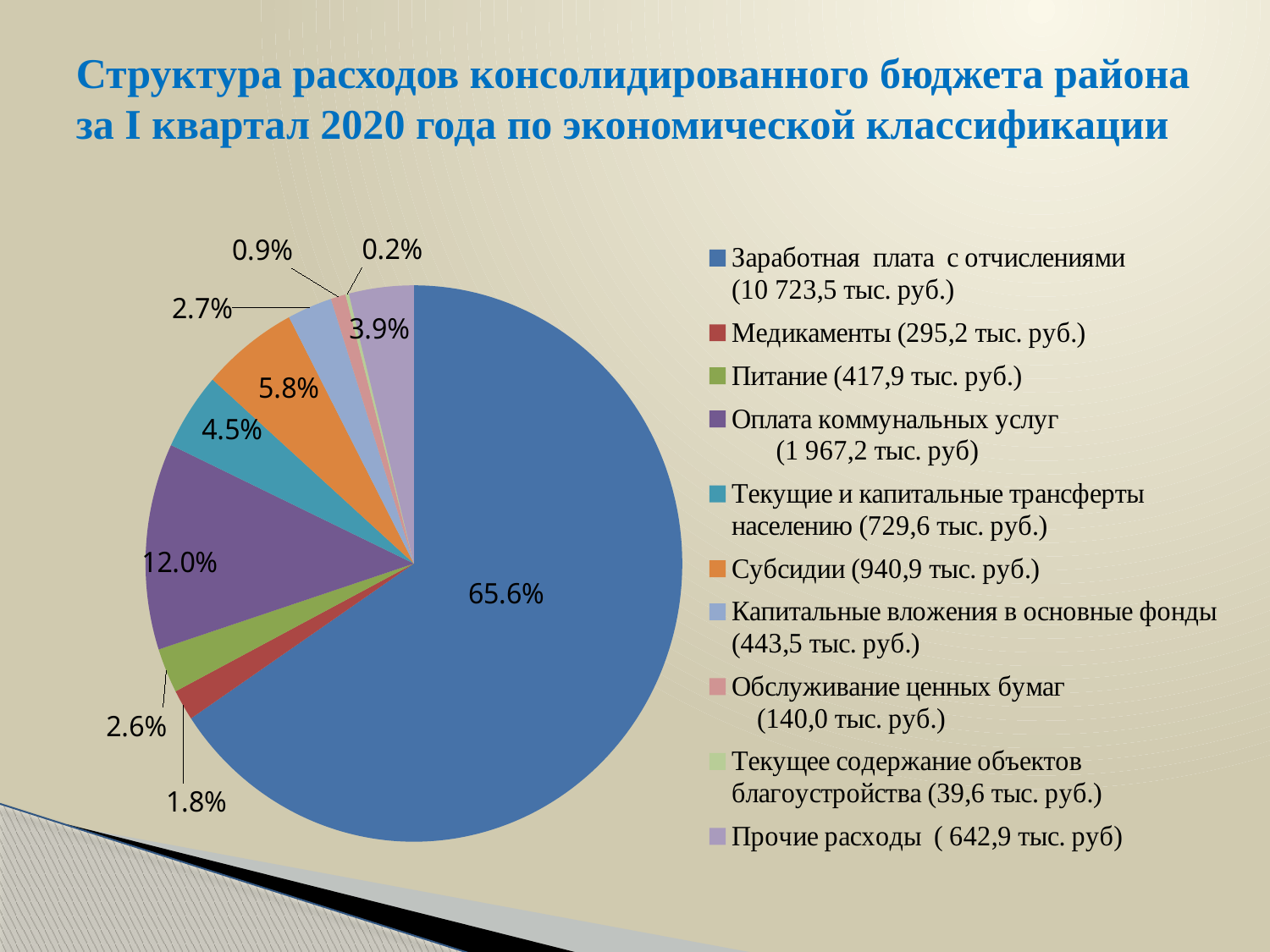
What percentage is shown for "Прочие расходы"? 3.9% Which category has the largest share of the pie? Заработная плата с отчислениями What type of chart is shown on the slide? pie chart What is the difference in percentage points between "Оплата коммунальных услуг" and "Субсидии"? 6.2 What percentage is shown for "Субсидии"? 5.8% What amount in thousand rubles does the legend give for "Медикаменты"? 295,2 тыс. руб. What share of the pie does "Заработная плата с отчислениями" take? 65.6% What percentage is shown for "Оплата коммунальных услуг"? 12.0% Which is larger: the share for "Питание" or the share for "Медикаменты"? Питание How many entries does the legend list? 10 How many slices does the pie chart have? 10 Which category has the smallest share of the pie? Текущее содержание объектов благоустройства